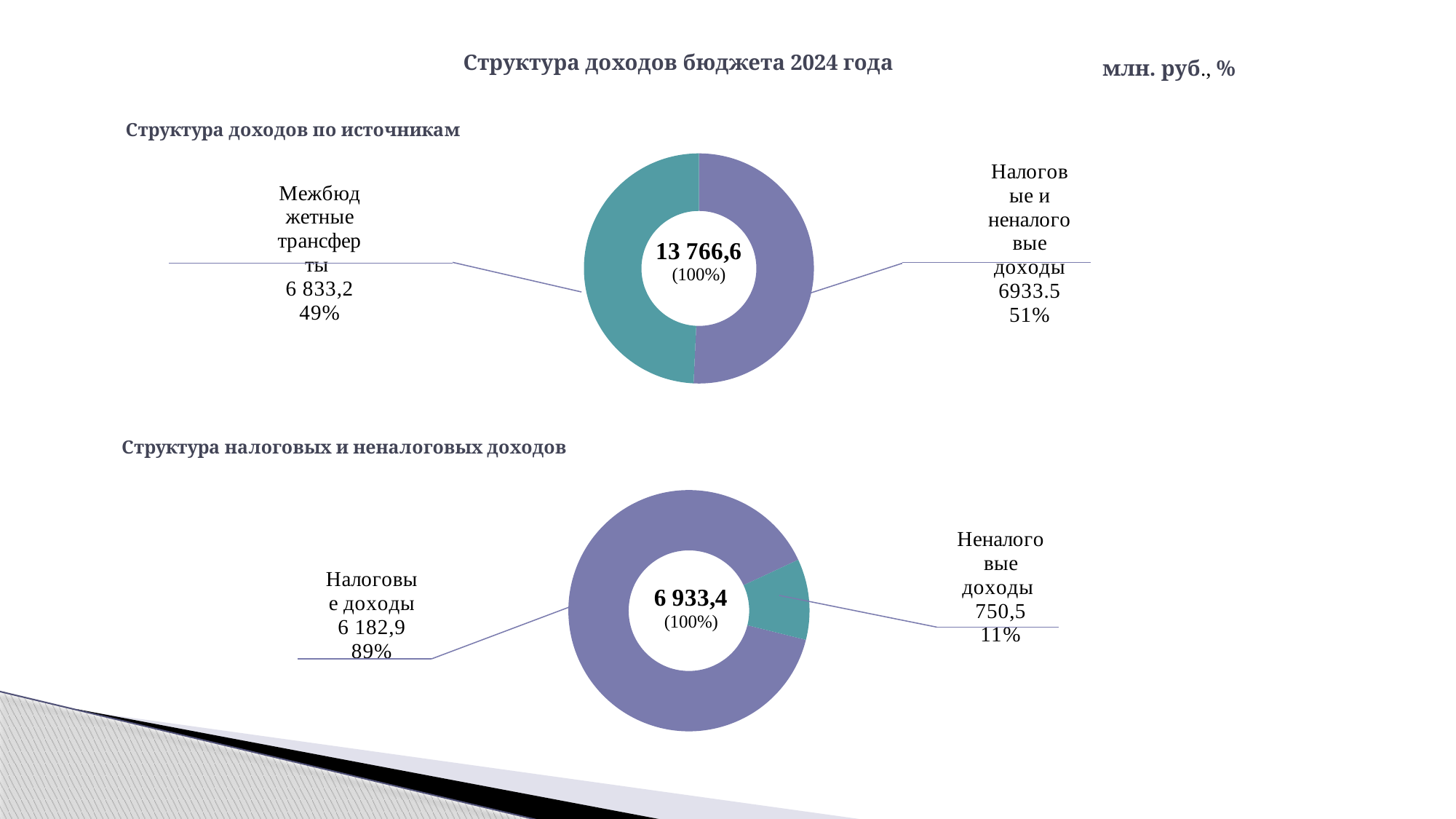
In the chart 'Структура доходов по источникам', what share of the total do Налоговые и неналоговые доходы make up? 51% In the chart 'Структура доходов по источникам', which category is larger: Межбюджетные трансферты or Налоговые и неналоговые доходы? Налоговые и неналоговые доходы In the chart 'Структура доходов по источникам', what is the value for Межбюджетные трансферты? 6 833,2 In the chart 'Структура налоговых и неналоговых доходов', which category is the smallest? Неналоговые доходы In the chart 'Структура налоговых и неналоговых доходов', what is the value for Неналоговые доходы? 750,5 In the chart 'Структура налоговых и неналоговых доходов', what is the difference between Налоговые доходы and Неналоговые доходы? 5 432,4 In the chart 'Структура налоговых и неналоговых доходов', what total value is shown in the centre of the doughnut? 6 933,4 In the chart 'Структура доходов по источникам', what total value is shown in the centre of the doughnut? 13 766,6 What is the main title of the slide? Структура доходов бюджета 2024 года In the chart 'Структура налоговых и неналоговых доходов', what share of the total do Налоговые доходы make up? 89% How many categories does the chart 'Структура доходов по источникам' show? 2 What type of chart is used for 'Структура налоговых и неналоговых доходов'? Doughnut chart